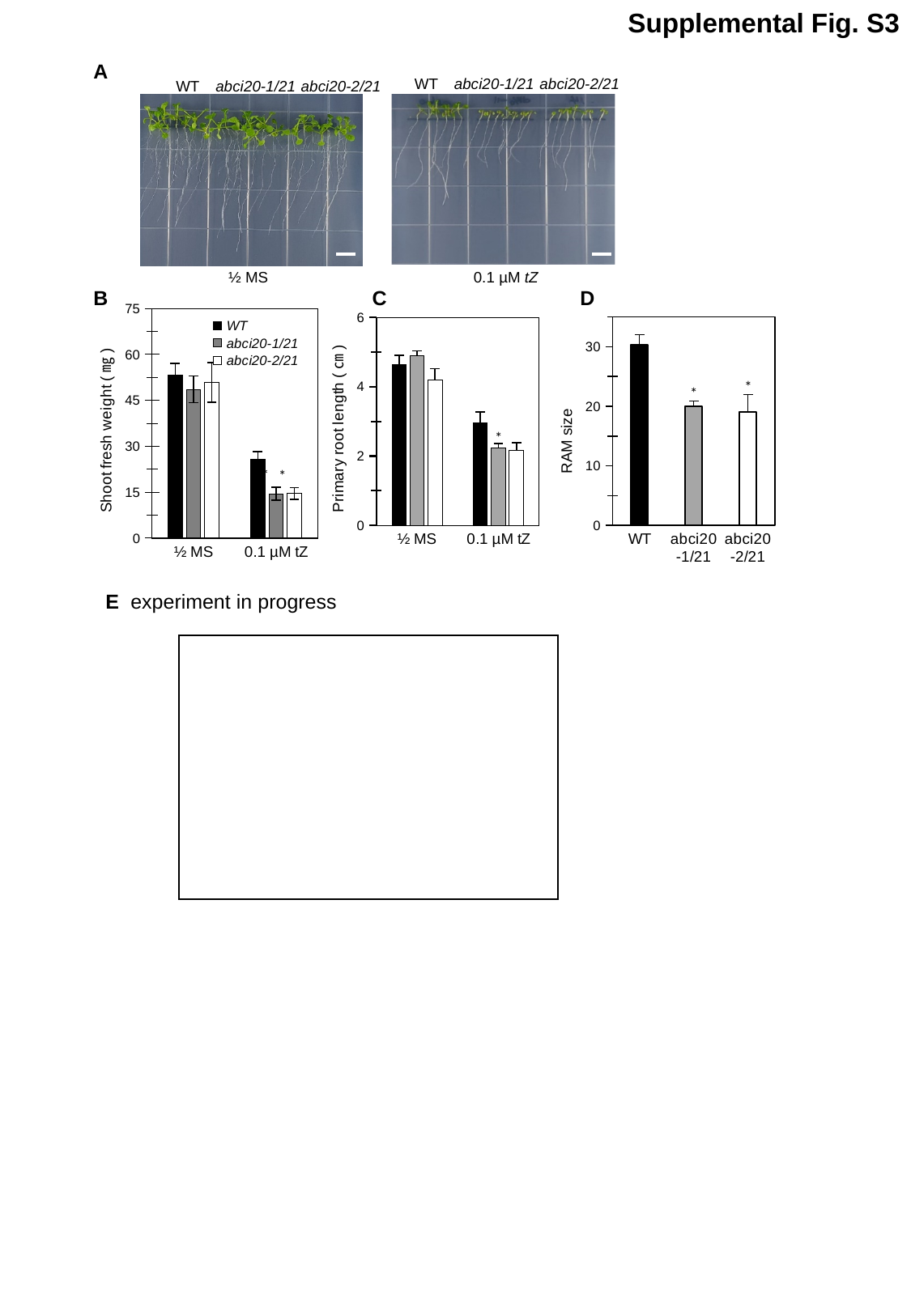
In chart B (Shoot fresh weight), is the value for abci20-1/21 under 0.1 µM tZ greater or less than 30? less What is the y-axis label of chart B? Shoot fresh weight (mg) In chart D (RAM size), which category has the highest value? WT In chart B (Shoot fresh weight), under 0.1 µM tZ, which is larger: WT or abci20-1/21? WT What kind of chart is chart B (Shoot fresh weight)? bar chart In chart C (Primary root length), is the value for abci20-1/21 under 0.1 µM tZ greater or less than 4? less In chart D (RAM size), how many bars are plotted? 3 In chart B (Shoot fresh weight), how many series does the legend list? 3 In chart D (RAM size), is the value for WT greater or less than 20? greater In chart C (Primary root length), how many categories are shown on the x axis? 2